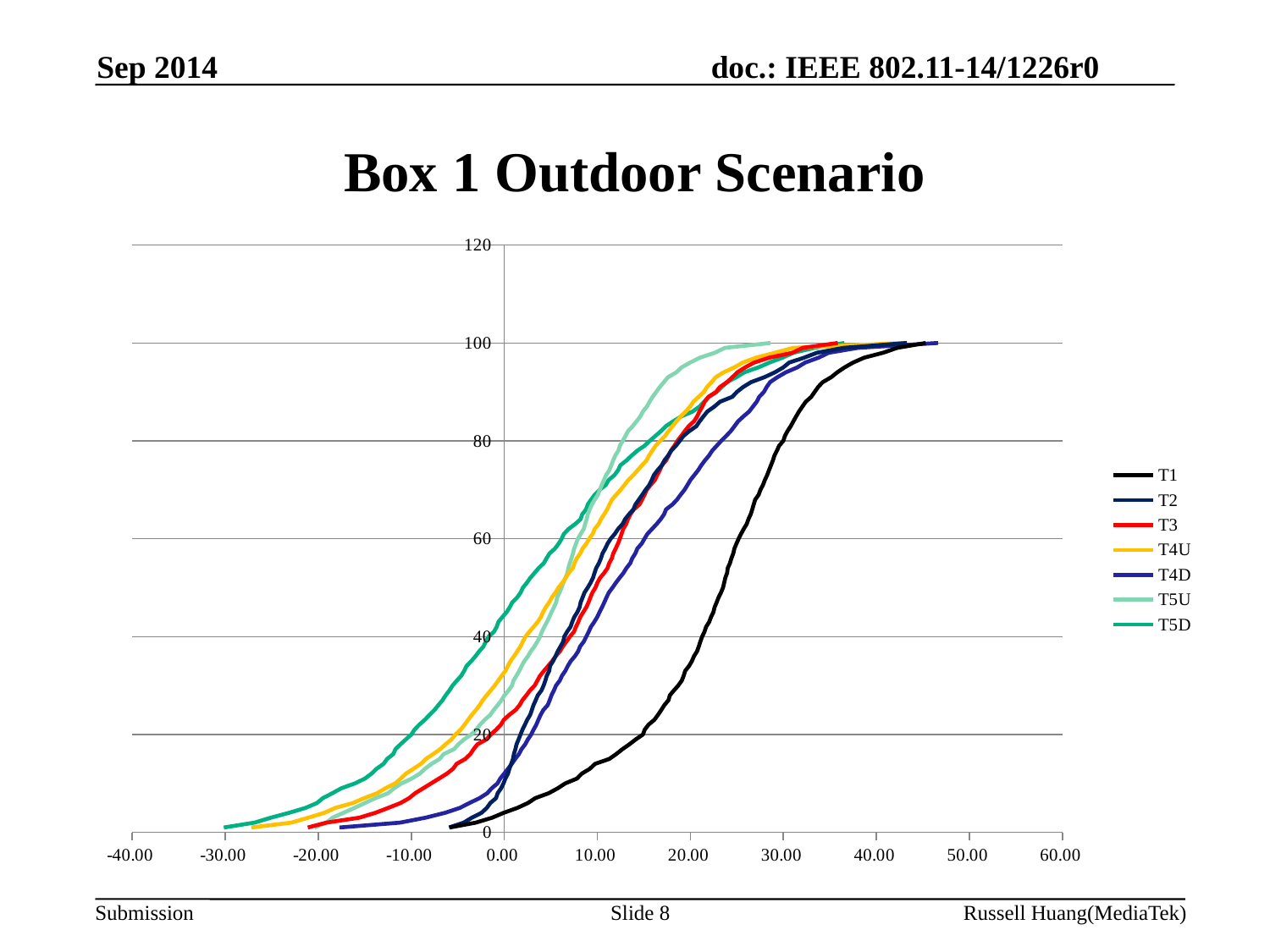
What is the title of the chart? Box 1 Outdoor Scenario Is the value of T1 at x = 20.00 greater or less than 40? less Which series starts at the lowest x value (furthest left)? T5D What kind of chart is shown on the slide? line chart Is the value of T3 at x = -10.00 greater or less than 20? less Is the value of T5D at x = 10.00 greater or less than 60? greater At x = 20.00, which series has the higher value, T1 or T5U? T5U How many series does the legend list? 7 Do the values of the T1 series rise or fall as x increases? rise Which series is drawn in black? T1